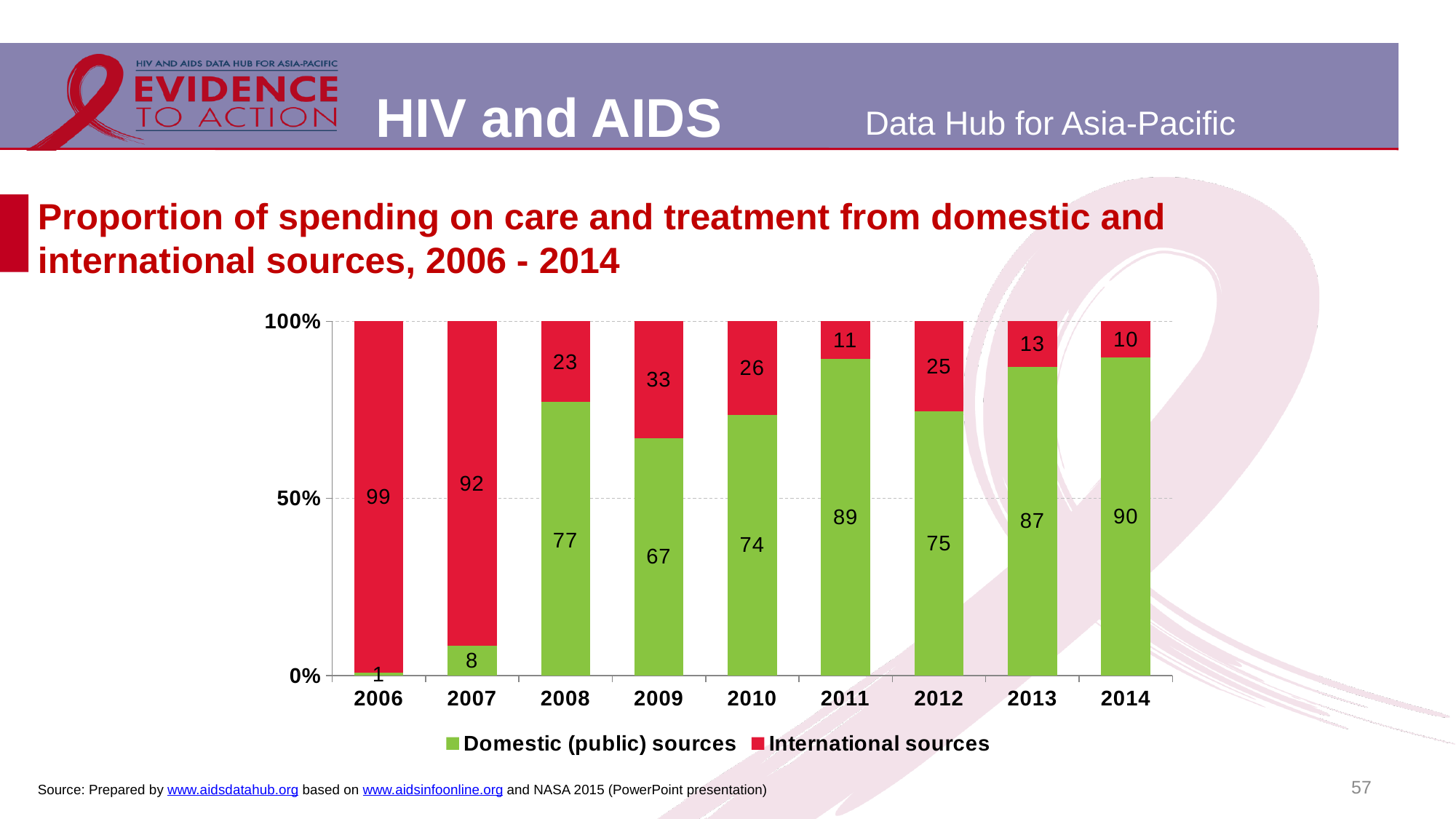
How many years are shown on the x axis? 9 What is the value for Domestic (public) sources in 2011? 89 What kind of chart is shown on the slide? Stacked bar chart Which year has the highest value for International sources? 2006 What is the value for International sources in 2009? 33 Does the Domestic (public) sources value rise or fall from 2006 to 2008? Rise Which year has the lowest value for Domestic (public) sources? 2006 How many series does the legend list? 2 Which is larger, the International sources value for 2010 or for 2012? 2010 What colour represents International sources in the chart? Red What is the difference between the Domestic (public) sources values for 2014 and 2008? 13 What is the value for Domestic (public) sources in 2006? 1